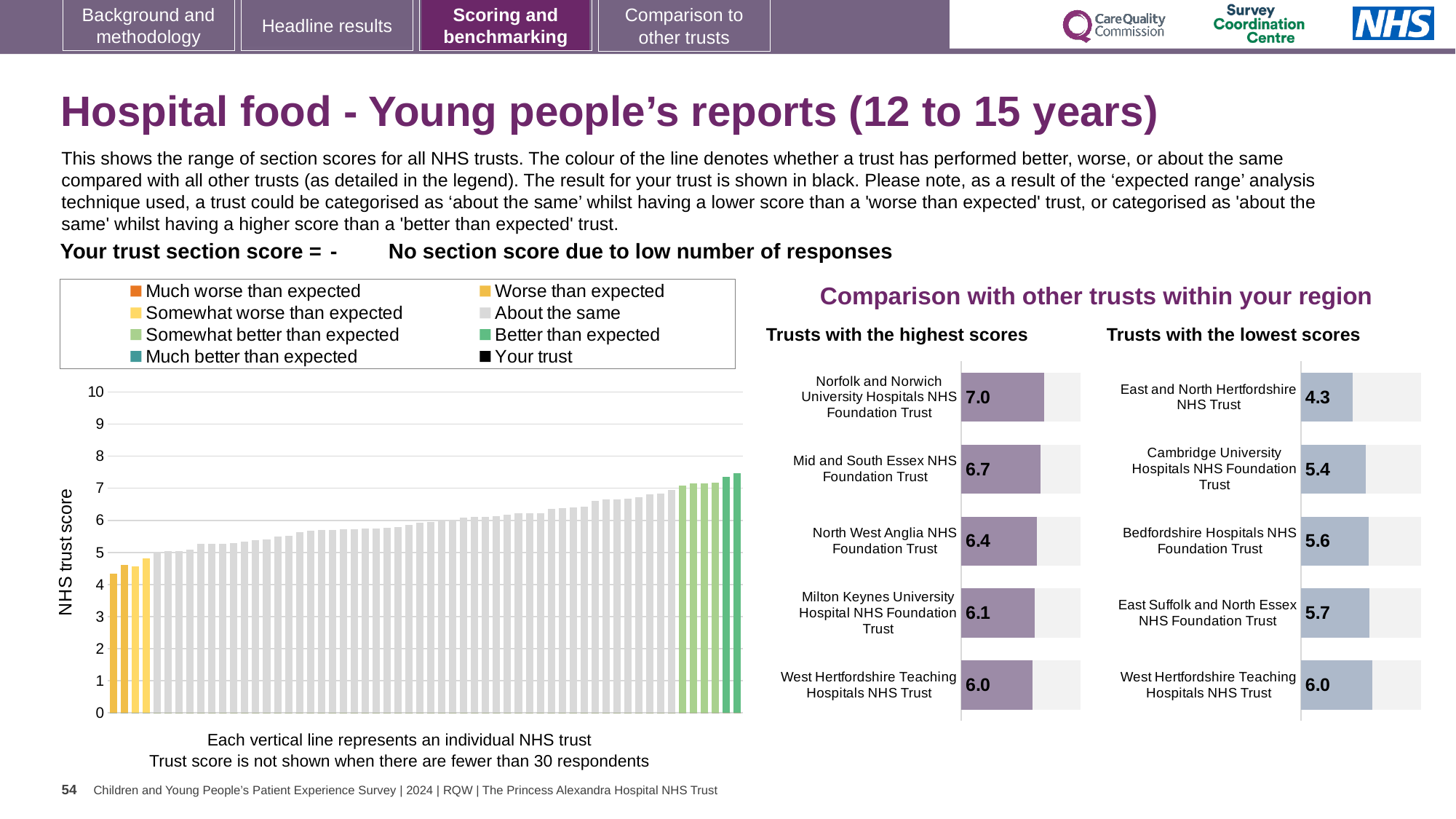
In the 'Trusts with the highest scores' chart, which trust has the highest score? Norfolk and Norwich University Hospitals NHS Foundation Trust In the 'Trusts with the lowest scores' chart, what is the score for East and North Hertfordshire NHS Trust? 4.3 In the large chart on the left showing the range of section scores, is the value of the leftmost bar greater or less than 5? less In the 'Trusts with the lowest scores' chart, what is the difference between the scores of Bedfordshire Hospitals NHS Foundation Trust and East and North Hertfordshire NHS Trust? 1.3 In the 'Trusts with the highest scores' chart, what is the difference between the scores of Norfolk and Norwich University Hospitals NHS Foundation Trust and West Hertfordshire Teaching Hospitals NHS Trust? 1.0 What kind of chart is the large chart on the left showing the range of section scores? bar chart In the 'Trusts with the lowest scores' chart, which has the higher score: Cambridge University Hospitals NHS Foundation Trust or East Suffolk and North Essex NHS Foundation Trust? East Suffolk and North Essex NHS Foundation Trust In the large chart on the left showing the range of section scores, do the values rise or fall from left to right? rise How many trusts are listed in the 'Trusts with the highest scores' chart? 5 In the 'Trusts with the highest scores' chart, what is the score for Norfolk and Norwich University Hospitals NHS Foundation Trust? 7.0 In the 'Trusts with the lowest scores' chart, which trust has the lowest score? East and North Hertfordshire NHS Trust In the 'Trusts with the highest scores' chart, what is the score for Milton Keynes University Hospital NHS Foundation Trust? 6.1